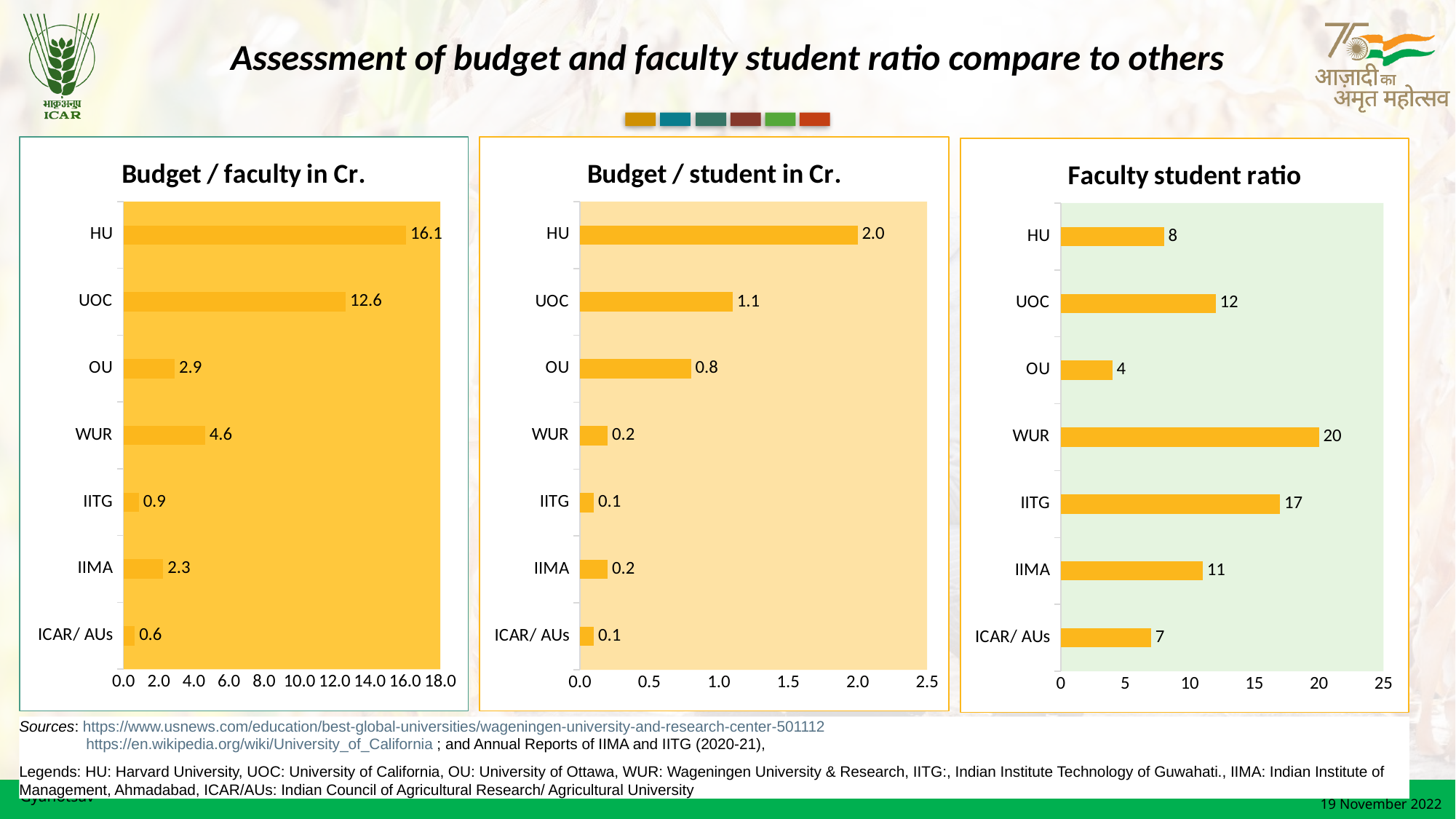
In the 'Budget / faculty in Cr.' chart, what is the value for HU? 16.1 In the 'Faculty student ratio' chart, which category has the highest value? WUR In the 'Budget / faculty in Cr.' chart, which category has the lowest value? ICAR/ AUs In the 'Budget / faculty in Cr.' chart, what is the difference between HU and UOC? 3.5 In the 'Faculty student ratio' chart, what is the difference between WUR and IIMA? 9 In the 'Budget / student in Cr.' chart, what is the value for OU? 0.8 How many categories are shown in the 'Faculty student ratio' chart? 7 In the 'Budget / student in Cr.' chart, which is larger, the value for UOC or the value for OU? UOC In the 'Budget / student in Cr.' chart, which category has the highest value? HU What type of chart is the 'Budget / faculty in Cr.' chart? Bar chart In the 'Faculty student ratio' chart, which category has the lowest value? OU In the 'Faculty student ratio' chart, what is the value for IITG? 17